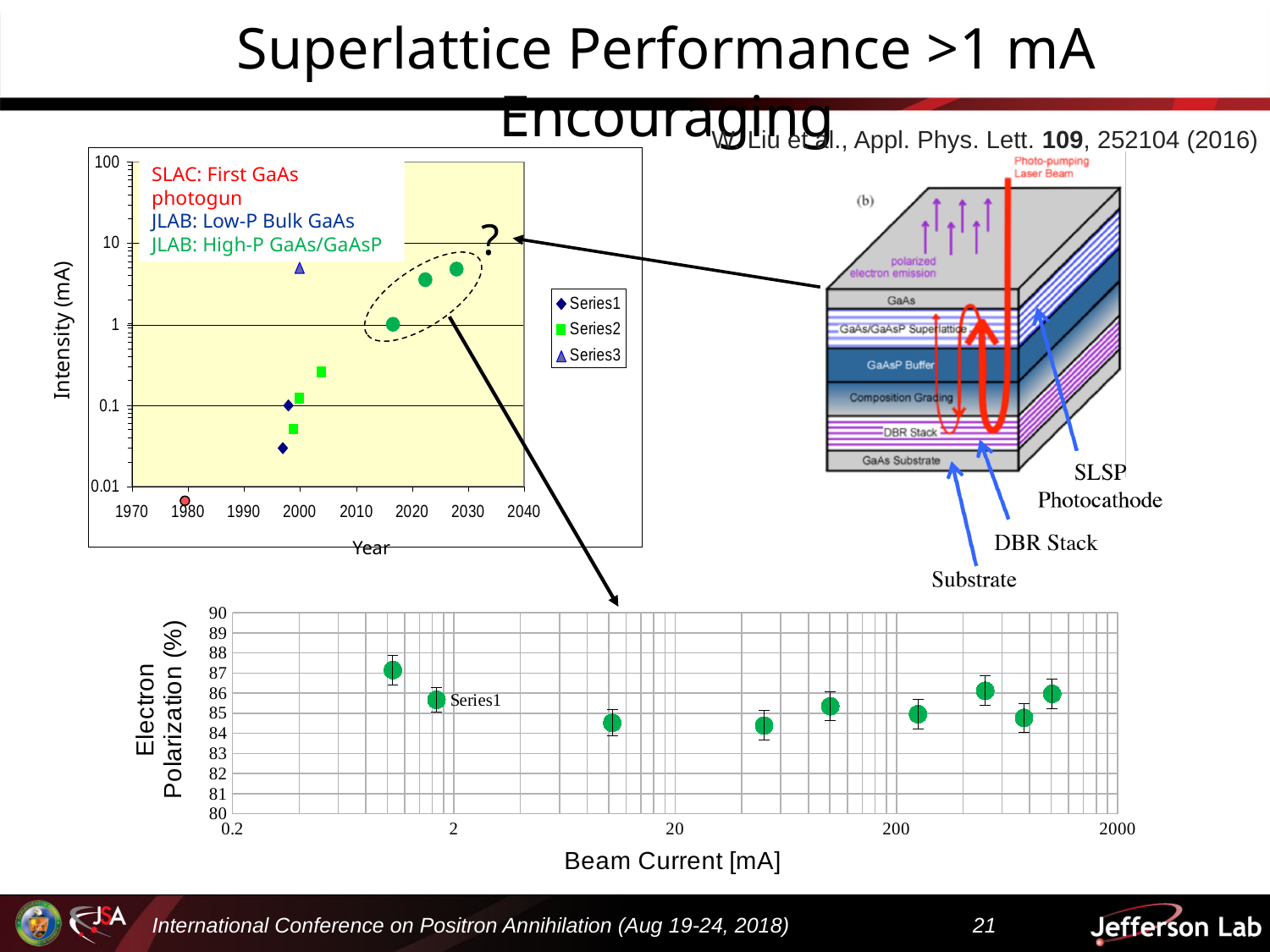
In the bottom chart, how many data points are plotted? 9 In the top-left chart, what is the label of the y axis? Intensity (mA) In the top-left chart, are the Series1 points greater or less than 1 mA in intensity? less In the bottom chart, is the electron polarization of the leftmost point (near 1 mA) greater or less than 86%? greater How many series does the legend of the bottom Electron Polarization chart list? 1 In the top-left chart, how many Series3 points are plotted? 1 What type of chart is the top-left chart of Intensity versus Year? scatter chart How many series does the legend of the top-left Intensity versus Year chart list? 3 In the top-left chart, is the intensity of the Series3 point greater or less than 1 mA? greater In the bottom chart, what is the label of the x axis? Beam Current [mA] In the top-left chart, which series has the higher intensity, Series1 or Series3? Series3 What type of chart is the bottom chart of Electron Polarization versus Beam Current? scatter chart